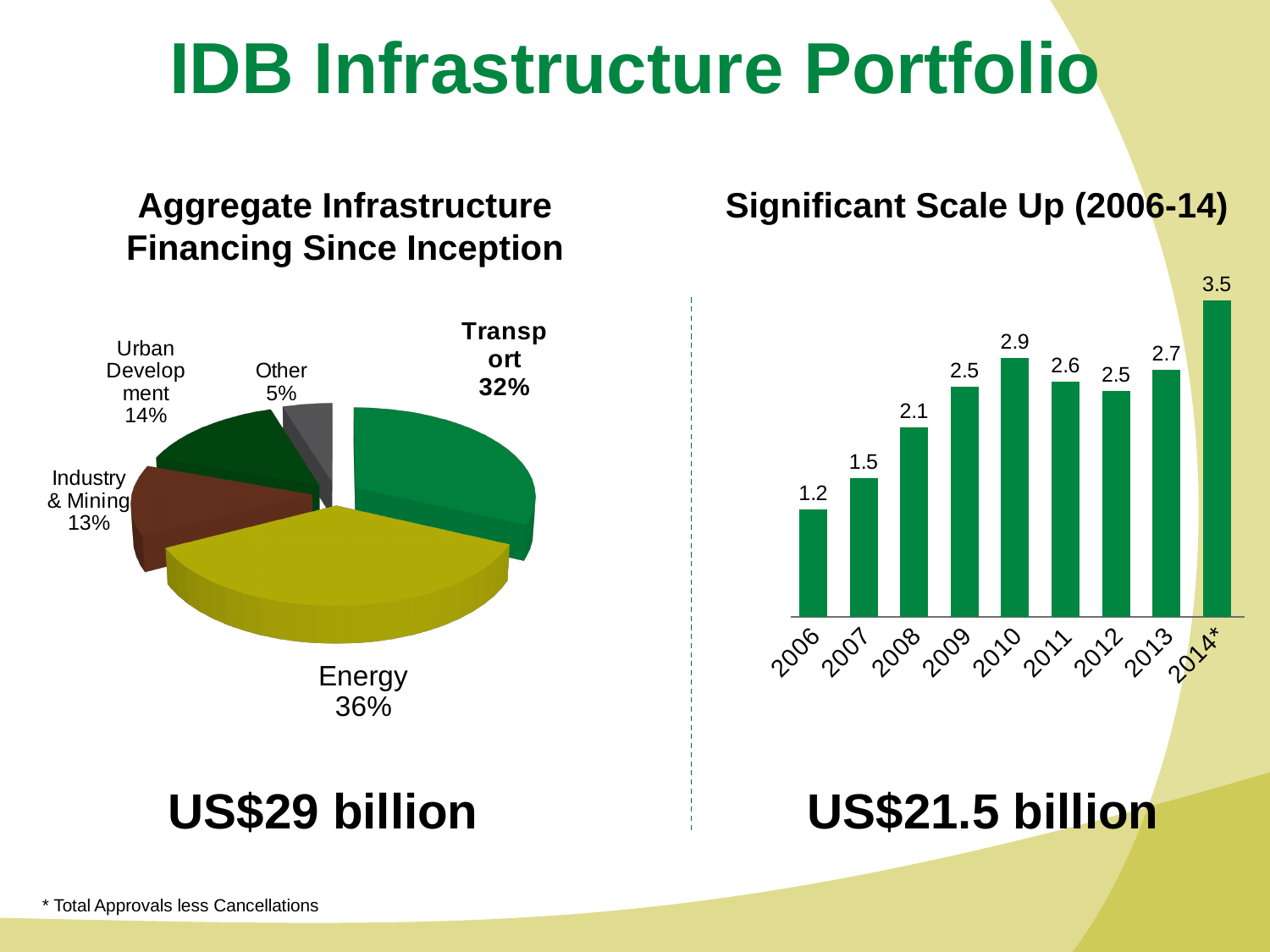
In the 'Significant Scale Up (2006-14)' chart, what is the value for 2010? 2.9 In the 'Aggregate Infrastructure Financing Since Inception' pie chart, what share does Transport have? 32% In the 'Aggregate Infrastructure Financing Since Inception' pie chart, which category has the smallest share? Other In the 'Significant Scale Up (2006-14)' chart, which year has the lowest value? 2006 What type of chart is 'Significant Scale Up (2006-14)'? Bar chart In the 'Aggregate Infrastructure Financing Since Inception' pie chart, which category has the largest share? Energy In the 'Significant Scale Up (2006-14)' chart, how many years are shown on the x axis? 9 In the 'Significant Scale Up (2006-14)' chart, what is the difference between the values for 2014* and 2006? 2.3 In the 'Significant Scale Up (2006-14)' chart, which year has the highest value? 2014* In the 'Aggregate Infrastructure Financing Since Inception' pie chart, what share does Energy have? 36% In the 'Aggregate Infrastructure Financing Since Inception' pie chart, what is the difference in percentage points between Urban Development and Industry & Mining? 1 percentage point In the 'Aggregate Infrastructure Financing Since Inception' pie chart, how many slices are there? 5